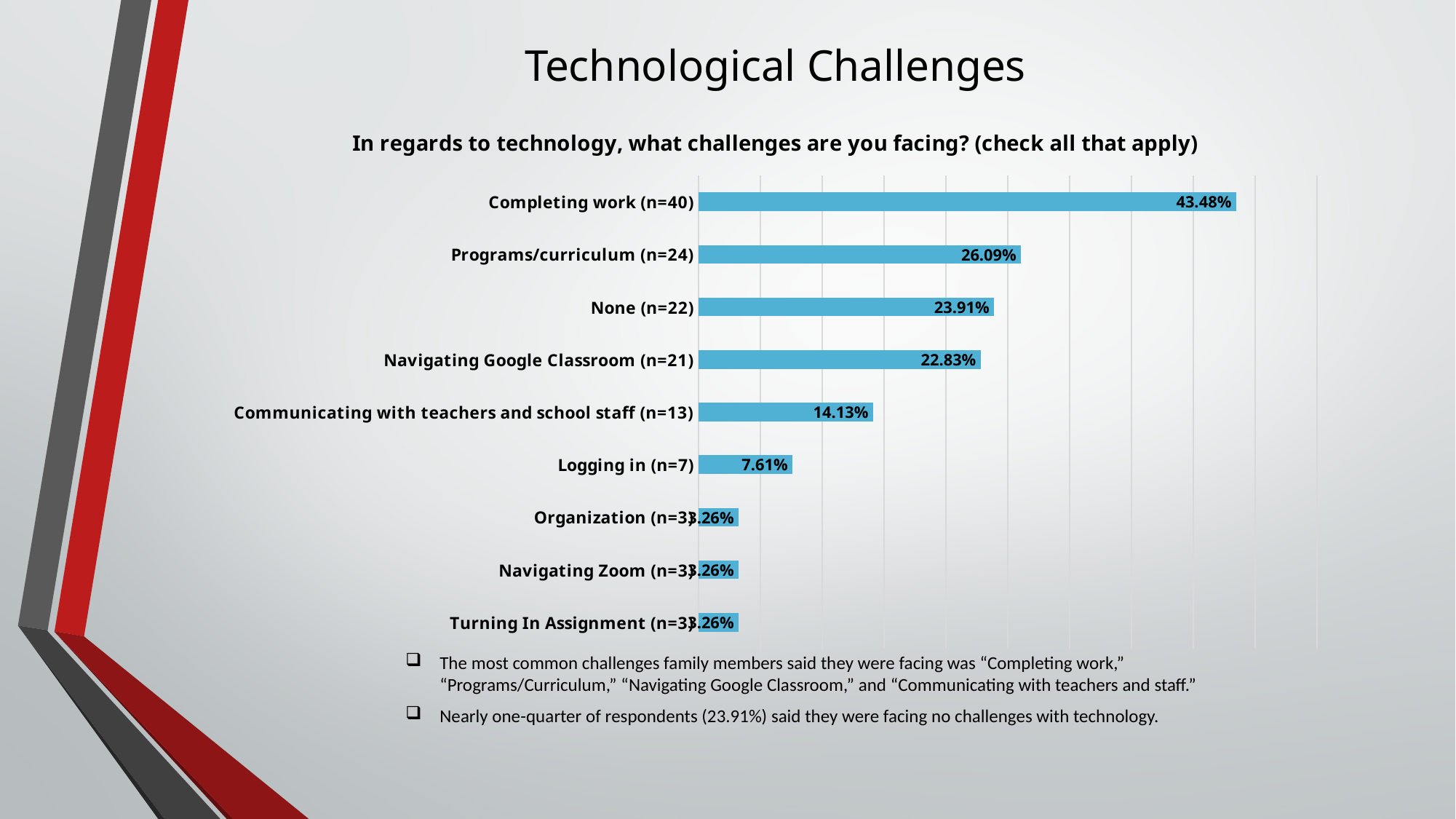
How many categories are shown in the chart? 9 What percentage is shown for Programs/curriculum (n=24)? 26.09% What is the difference between Navigating Google Classroom and Communicating with teachers and school staff? 8.70% What percentage is shown for Logging in (n=7)? 7.61% What is the value for Navigating Google Classroom (n=21)? 22.83% What is the difference in percentage points between Completing work and Programs/curriculum? 17.39% Which challenge has the highest percentage? Completing work (n=40) What percentage of respondents selected None (n=22)? 23.91% What is the value for Communicating with teachers and school staff (n=13)? 14.13% What percentage is shown for Completing work (n=40)? 43.48% What type of chart is shown on the slide? Bar chart Which is larger, the value for None or the value for Navigating Google Classroom? None